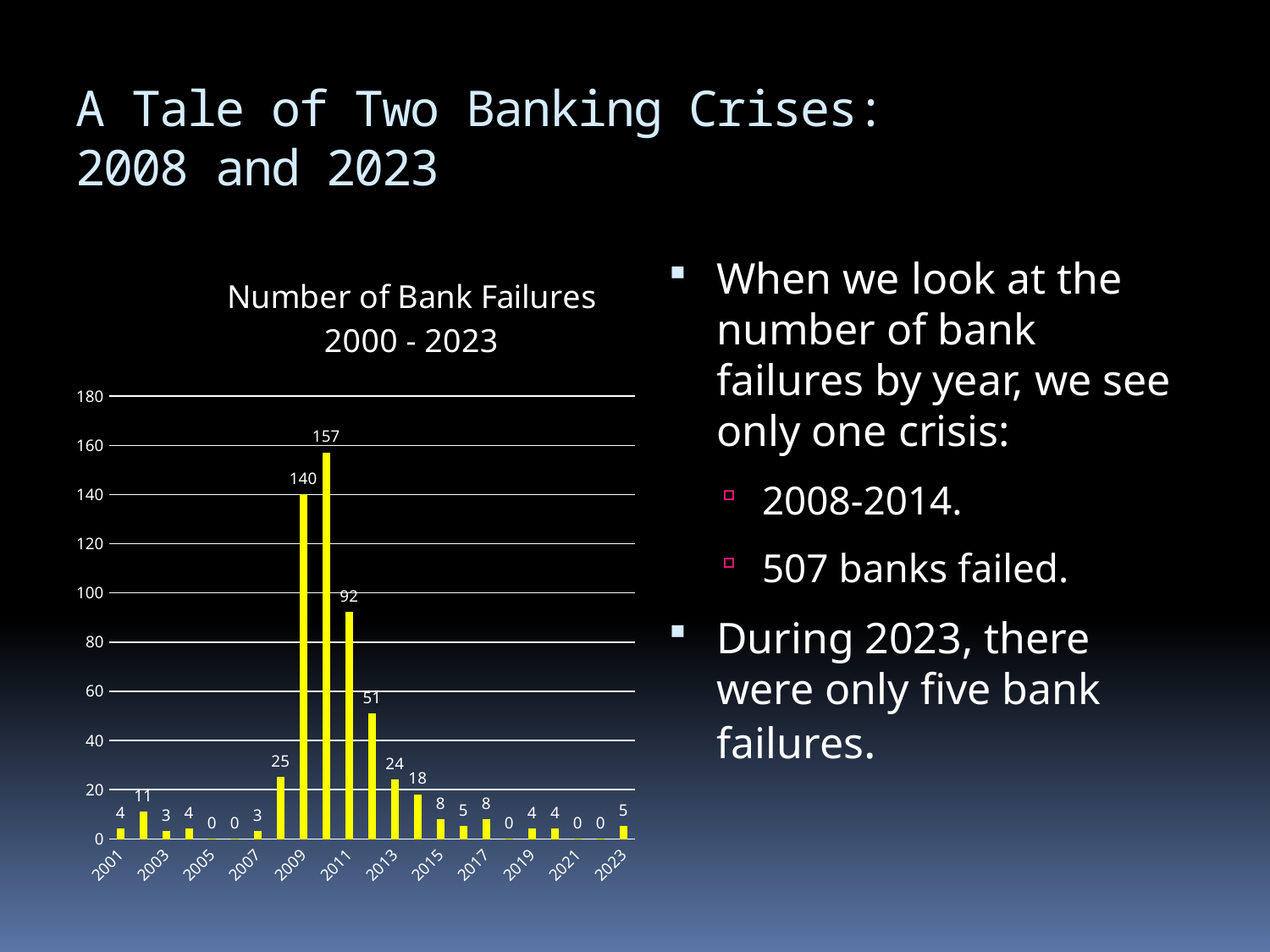
What is the number of bank failures shown for 2011? 92 What kind of chart is shown on the slide? bar chart What is the lowest number of bank failures shown on the chart? 0 What is the title of the chart? Number of Bank Failures 2000 - 2023 Is the value for 2009 greater or less than 120? greater What is the highest number of bank failures shown on the chart? 157 Do the values rise or fall from 2009 to 2015? fall What is the number of bank failures shown for 2009? 140 What is the difference between the number of bank failures in 2009 and in 2011? 48 What is the number of bank failures shown for 2013? 24 What is the number of bank failures shown for 2023? 5 Which year had more bank failures, 2013 or 2015? 2013